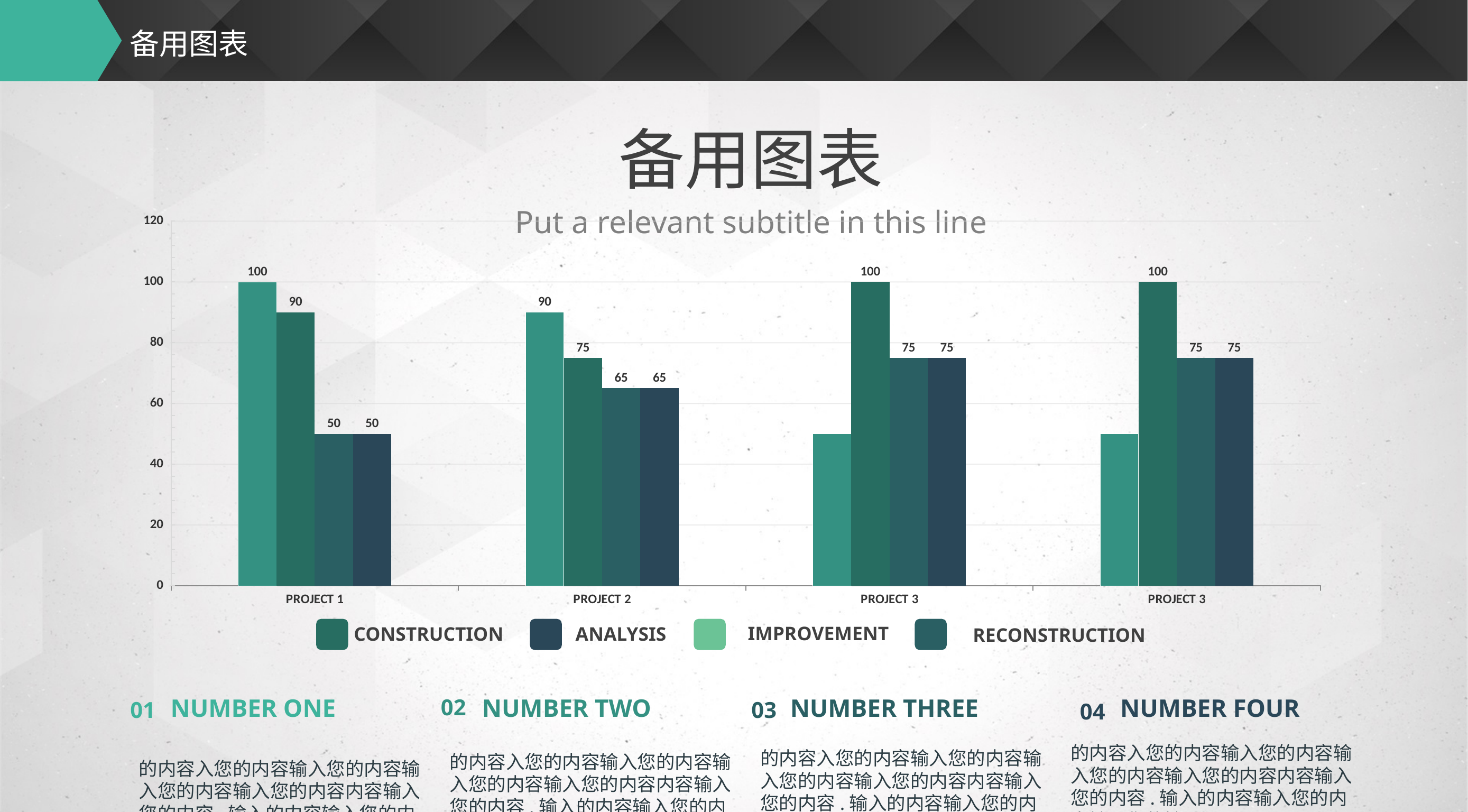
Which group has the larger leftmost bar, PROJECT 1 or PROJECT 2? PROJECT 1 How many category groups are plotted along the x axis? 4 What is the value of the leftmost bar in the PROJECT 2 group? 90 What is the value of the two shortest labeled bars in the PROJECT 2 group? 65 What is the value of the two shortest bars in the PROJECT 1 group? 50 How many series does the chart legend list? 4 What is the difference between the leftmost bar (90) and the second bar (75) in the PROJECT 2 group? 15 What is the value of the tallest bar in the PROJECT 1 group? 100 What kind of chart is shown on the slide? bar chart What is the difference between the tallest bar (100) and the shortest bar (50) in the PROJECT 1 group? 50 Which x-axis category label appears twice on the chart? PROJECT 3 Is the value of the unlabeled leftmost bar in the first PROJECT 3 group greater or less than 60? less